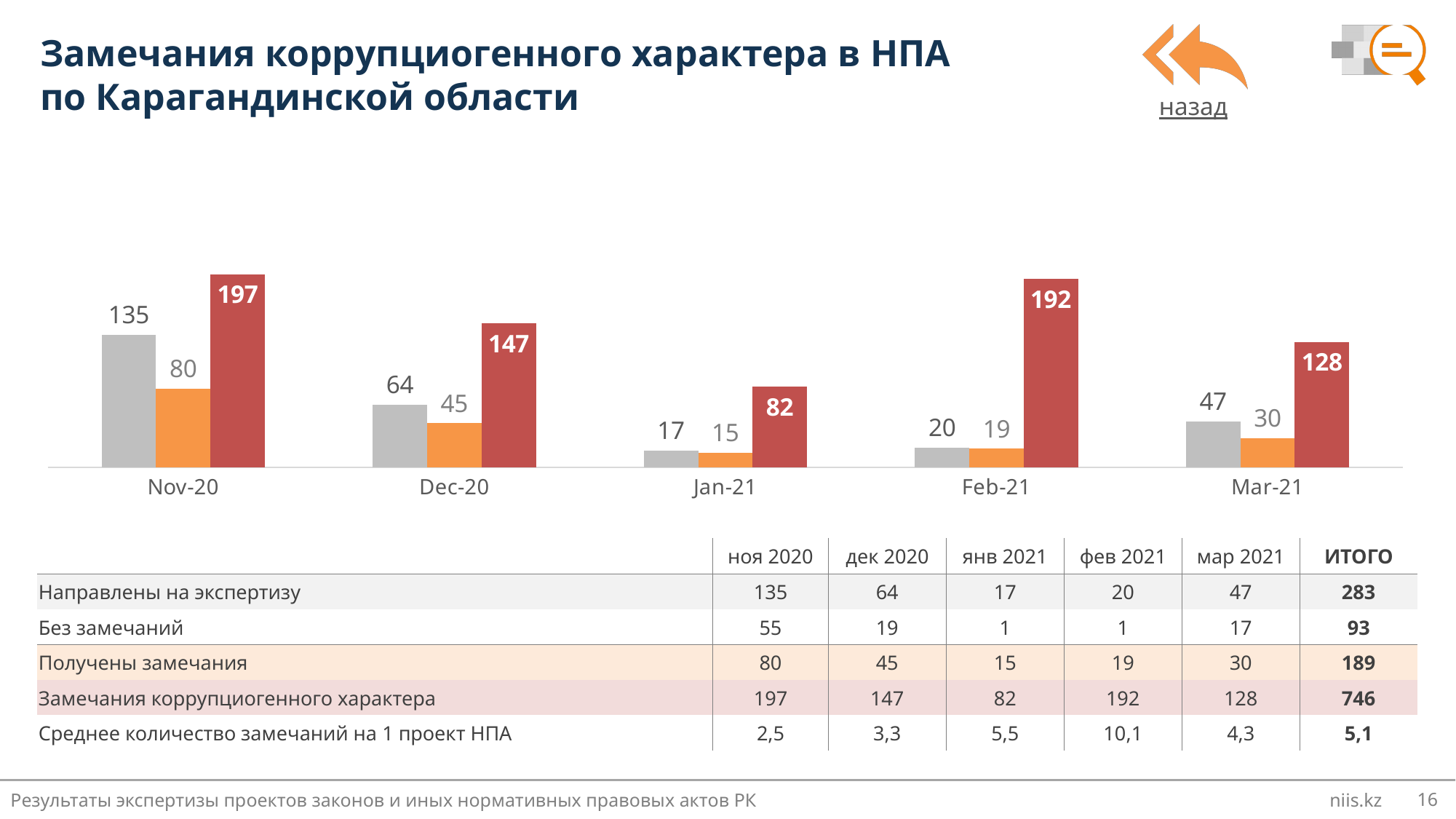
In which month is the red bar (Замечания коррупциогенного характера) highest? Nov-20 What is the difference between the grey and orange bar values for Nov-20? 55 What is the value of the orange bar (Получены замечания) for Mar-21? 30 Which is larger: the orange bar for Dec-20 or the orange bar for Mar-21? Dec-20 What is the difference between the red bar values for Nov-20 and Dec-20? 50 Do the grey bar values (Направлены на экспертизу) rise or fall from Nov-20 to Jan-21? fall What is the value of the red bar (Замечания коррупциогенного характера) for Feb-21? 192 How many months (categories) are shown on the x axis of the chart? 5 How many bars are shown for each month in the chart? 3 What type of chart is shown on the slide? bar chart What is the value of the grey bar (Направлены на экспертизу) for Nov-20? 135 In which month is the grey bar (Направлены на экспертизу) lowest? Jan-21